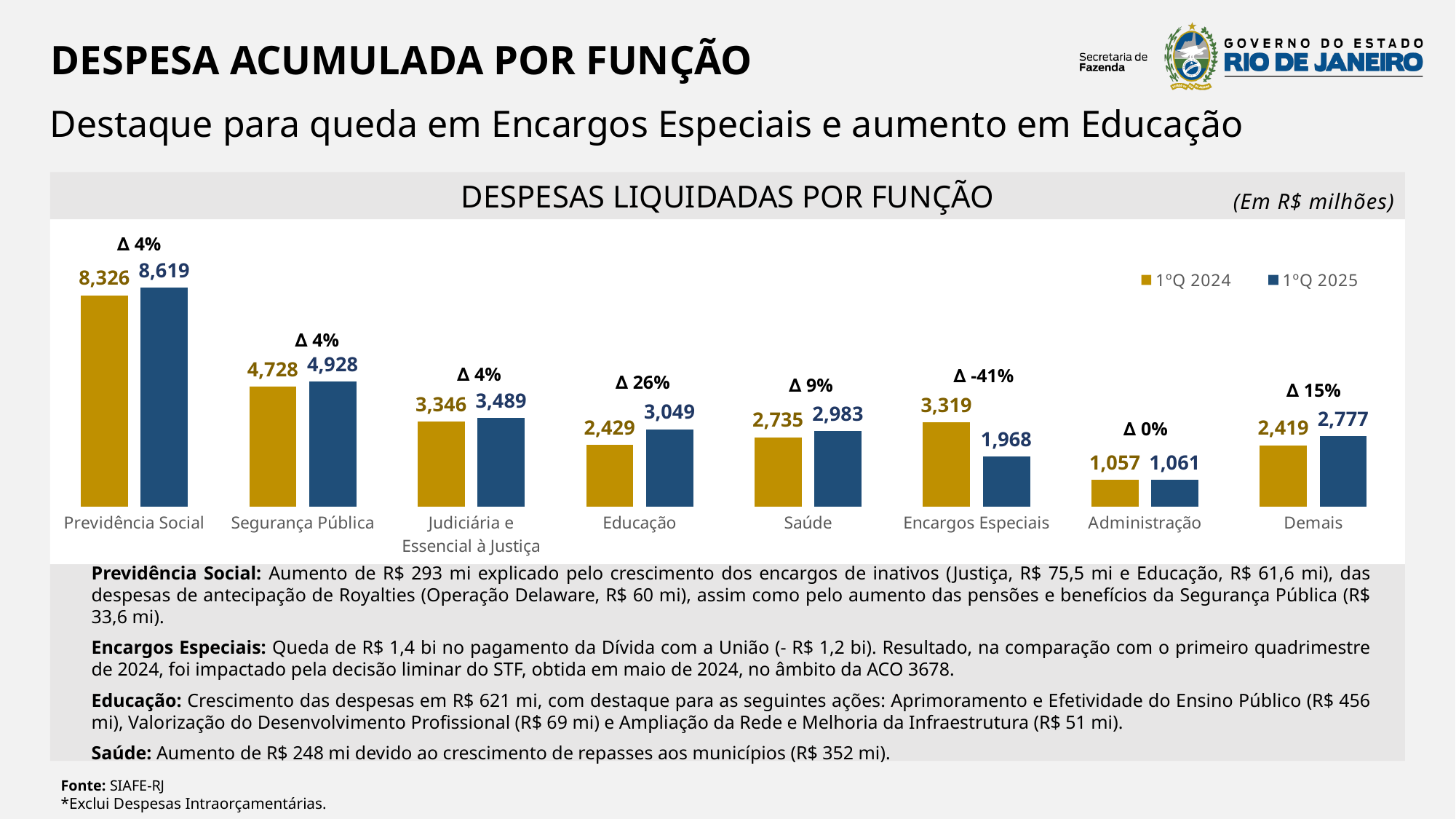
How many categories are shown on the x axis of the chart? 8 What percentage change is shown above the bars for Demais? Δ 15% What is the value for Educação in 1°Q 2025? 3,049 What is the value for Previdência Social in 1°Q 2025? 8,619 How many series does the legend list? 2 What is the difference between the 1°Q 2024 and 1°Q 2025 values for Encargos Especiais? 1,351 What is the difference between the 1°Q 2025 and 1°Q 2024 values for Educação? 620 What is the value for Encargos Especiais in 1°Q 2024? 3,319 Which is larger for Saúde: the 1°Q 2024 value or the 1°Q 2025 value? 1°Q 2025 What kind of chart is shown on the slide? Bar chart Which category has the highest value in 1°Q 2024? Previdência Social Which category has the lowest value in 1°Q 2025? Administração